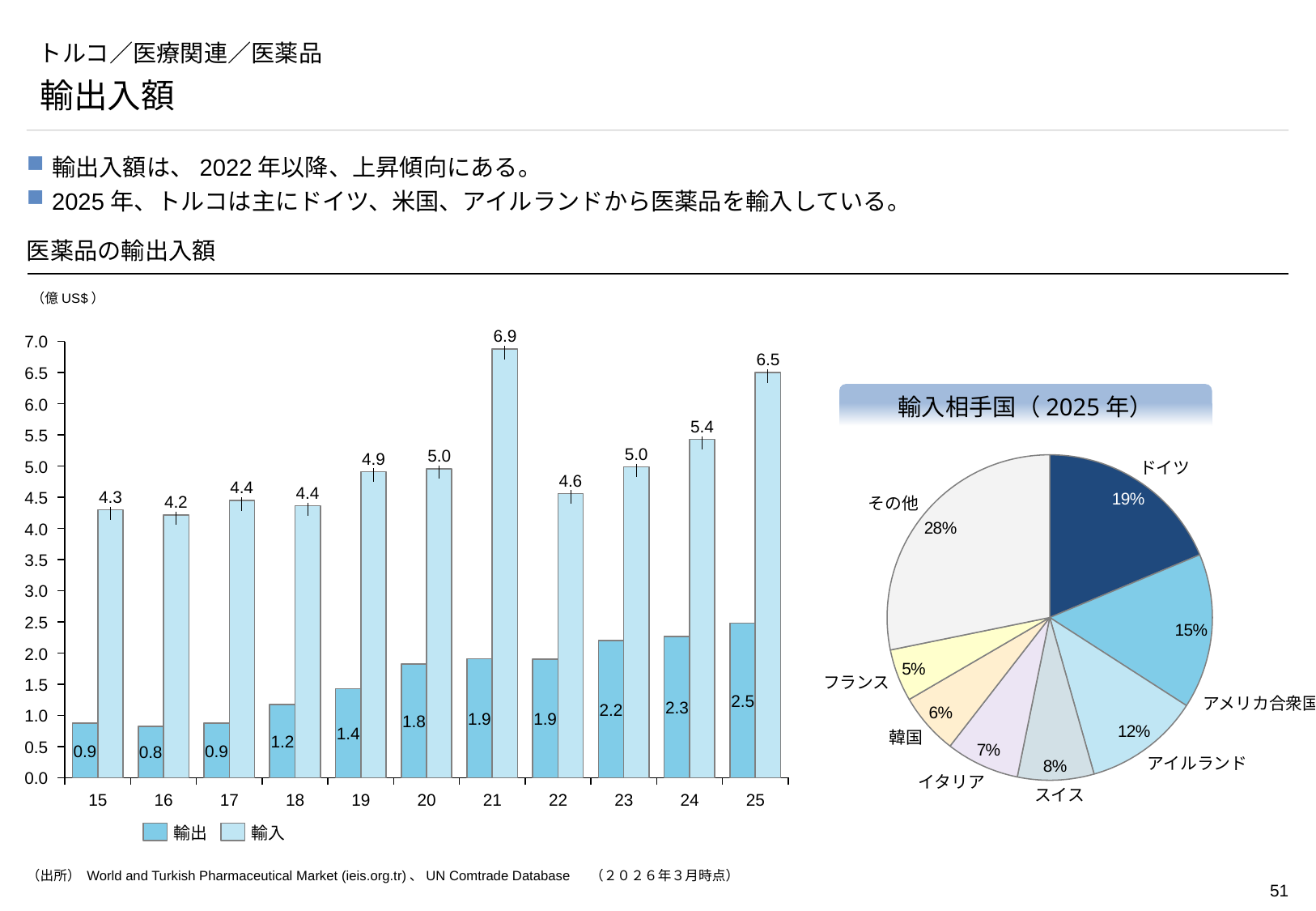
「輸入相手国（2025年）」の円グラフで、ドイツの割合はいくらですか？ 19% 「医薬品の輸出入額」のグラフで、24年の輸入と22年の輸入ではどちらが大きいですか？ 24年の輸入 「医薬品の輸出入額」のグラフで、25年の輸入と輸出の差はいくらですか？ 4.0 「医薬品の輸出入額」のグラフで、21年の輸入の値はいくらですか？ 6.9 「医薬品の輸出入額」のグラフで、輸入が最も高い年はどれですか？ 21 「医薬品の輸出入額」のグラフで、輸出は15年から25年にかけて全体的に上昇していますか、下降していますか？ 上昇 「輸入相手国（2025年）」の円グラフには、いくつの区分がありますか？ 8 「輸入相手国（2025年）」の円グラフで、最も割合が大きい国（その他を除く）はどこですか？ ドイツ 「医薬品の輸出入額」のグラフは何の種類のグラフですか？ 棒グラフ 「医薬品の輸出入額」のグラフで、輸出が最も低い年はどれですか？ 16 「医薬品の輸出入額」のグラフで、凡例にはいくつの系列がありますか？ 2 「医薬品の輸出入額」のグラフで、25年の輸出の値はいくらですか？ 2.5